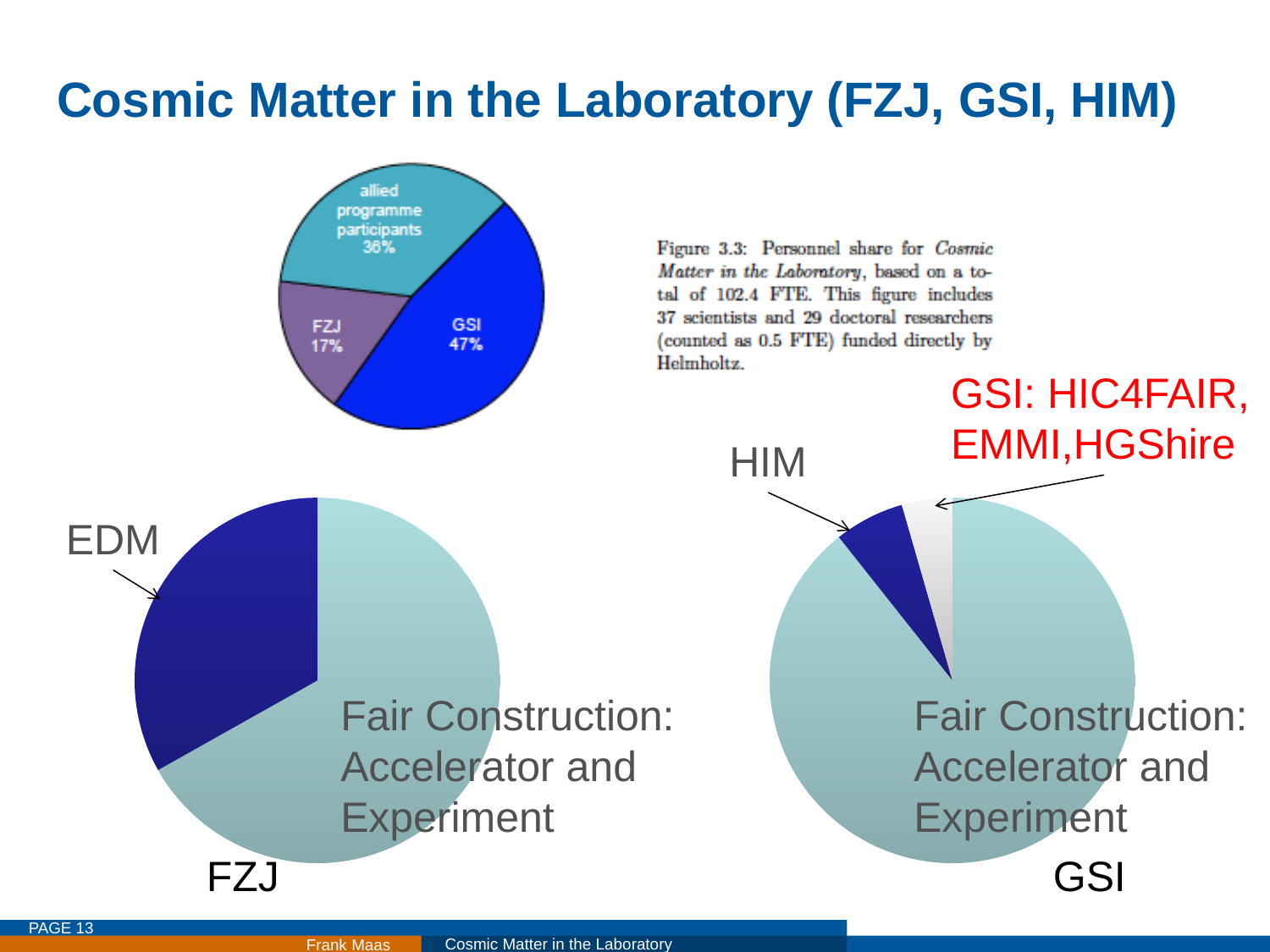
In the top pie chart (Figure 3.3, personnel share), what is the difference in percentage points between GSI and FZJ? 30 In the bottom-left pie chart labelled FZJ, which slice is the largest? Fair Construction: Accelerator and Experiment How many slices does the top pie chart (Figure 3.3, personnel share) have? 3 In the top pie chart (Figure 3.3, personnel share), which slice is the smallest? FZJ In the bottom-right pie chart labelled GSI, which slice is the largest? Fair Construction: Accelerator and Experiment What kind of chart is the bottom-left chart labelled FZJ? Pie chart In the top pie chart (Figure 3.3, personnel share), which slice is the largest? GSI In the top pie chart (Figure 3.3, personnel share), what percentage is shown for allied programme participants? 36% In the top pie chart (Figure 3.3, personnel share), what percentage is shown for GSI? 47% In the top pie chart (Figure 3.3, personnel share), which is larger: the GSI share or the allied programme participants share? GSI In the top pie chart (Figure 3.3, personnel share), what percentage is shown for FZJ? 17% How many slices does the bottom-right pie chart labelled GSI have? 3